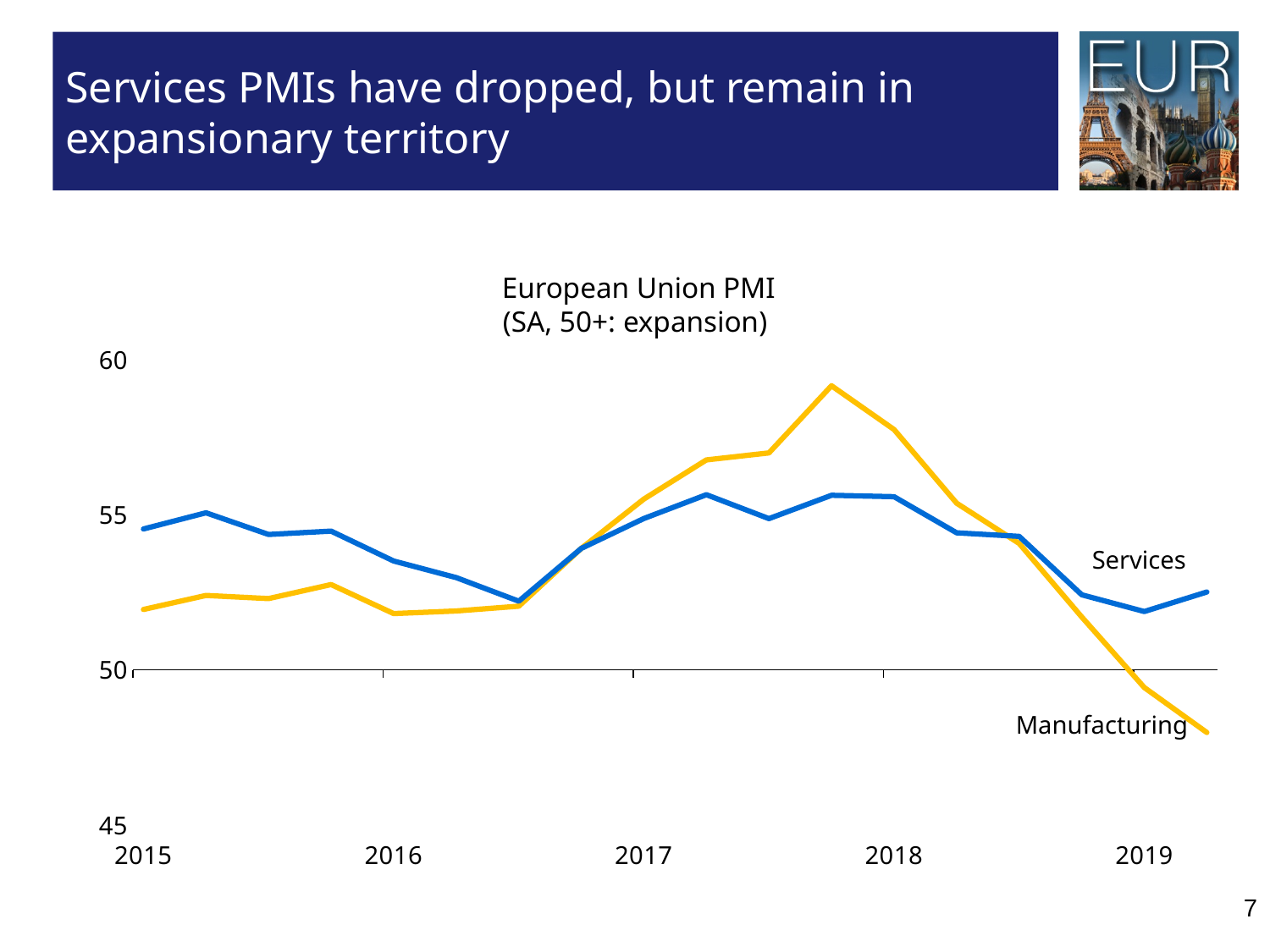
Which series has the lower value at the end of the period in 2019? Manufacturing What is the title of the chart? European Union PMI (SA, 50+: expansion) How many series are plotted on the chart? 2 Which series reaches the higher peak value over the period shown? Manufacturing Is the peak value of Manufacturing in late 2017 greater or less than 55? greater Is the value for Services at the end of the series in 2019 greater or less than 50? greater Does the Manufacturing series rise or fall between its late-2017 peak and 2019? fall Which series is drawn in yellow? Manufacturing At the start of 2015, which series has the larger value, Services or Manufacturing? Services Is the value for Manufacturing at the end of the series in 2019 greater or less than 50? less What kind of chart is shown on the slide? line chart